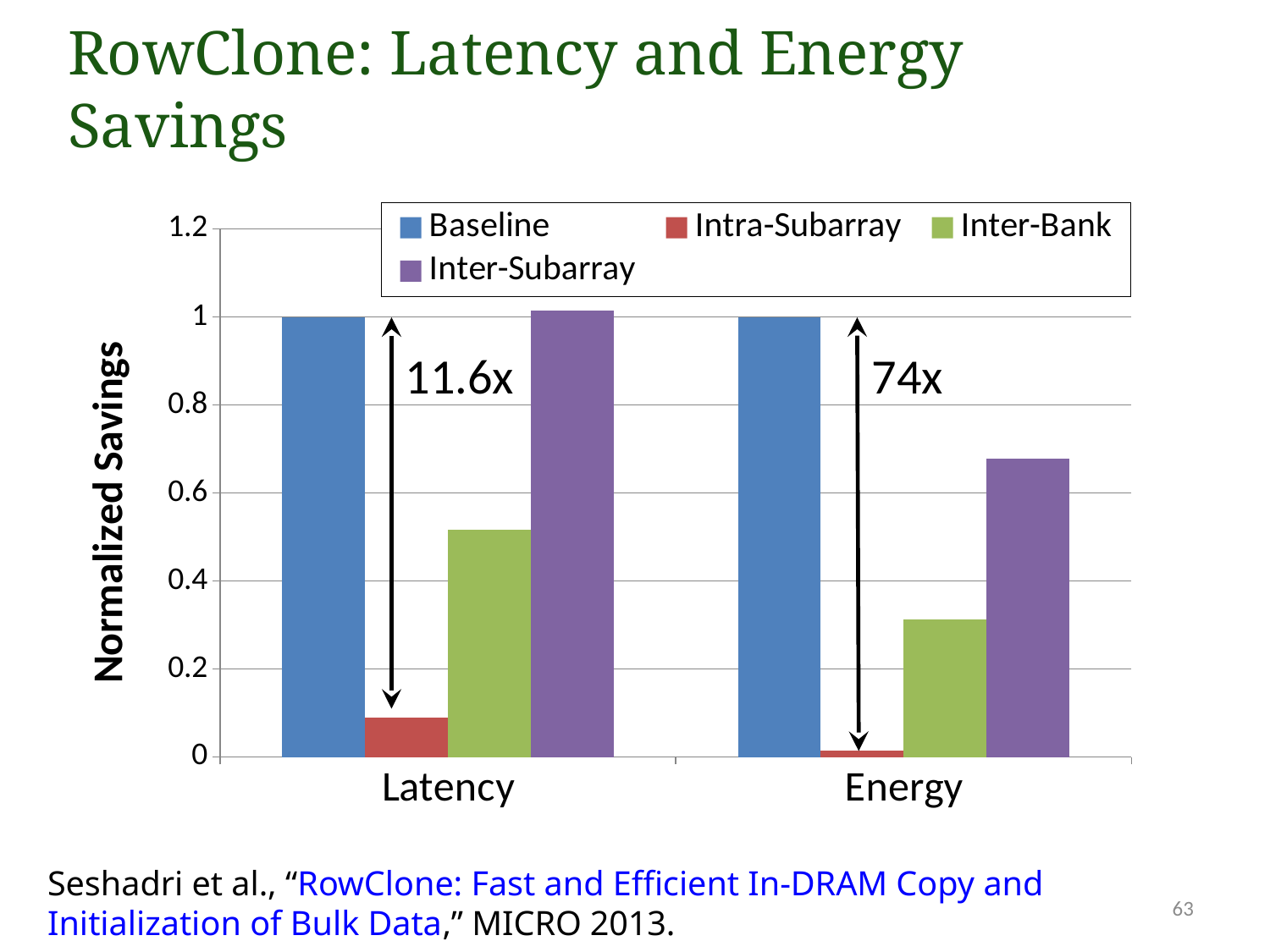
What is the Baseline value for Latency? 1 Is the Intra-Subarray value for Latency greater or less than 0.2? less What is the Baseline value for Energy? 1 Which series has the lowest value for Latency? Intra-Subarray Which series has the lowest value for Energy? Intra-Subarray Is the Inter-Bank value for Latency greater or less than 0.4? greater How many series does the legend list? 4 How many categories are shown on the x axis? 2 What kind of chart is shown on the slide? bar chart Which is larger for Energy: the Inter-Bank value or the Inter-Subarray value? Inter-Subarray What improvement factor is annotated above the Energy bars? 74x Is the Inter-Subarray value for Energy greater or less than 0.8? less